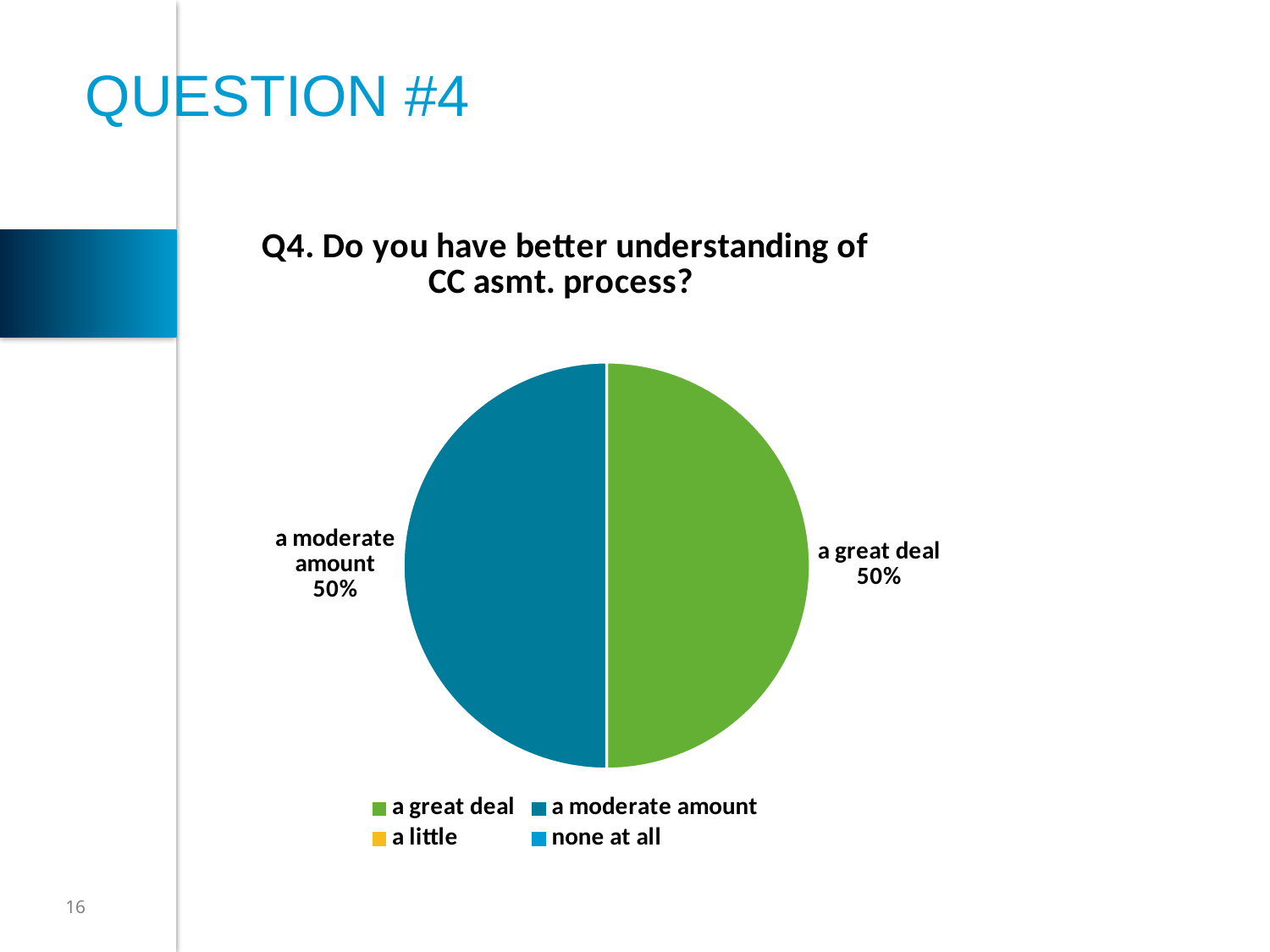
What is the title of the chart? Q4. Do you have better understanding of CC asmt. process? Is the share for "a great deal" greater or less than 40%? greater Which colour represents "a great deal" in the chart? green What share of the pie is labelled "a moderate amount"? 50% What is the difference between the shares for "a great deal" and "a moderate amount"? 0% How many entries does the legend list? 4 What is the combined share of "a great deal" and "a moderate amount"? 100% What kind of chart is shown on the slide? pie chart What share of the pie is labelled "a great deal"? 50% How many slices are visible in the pie? 2